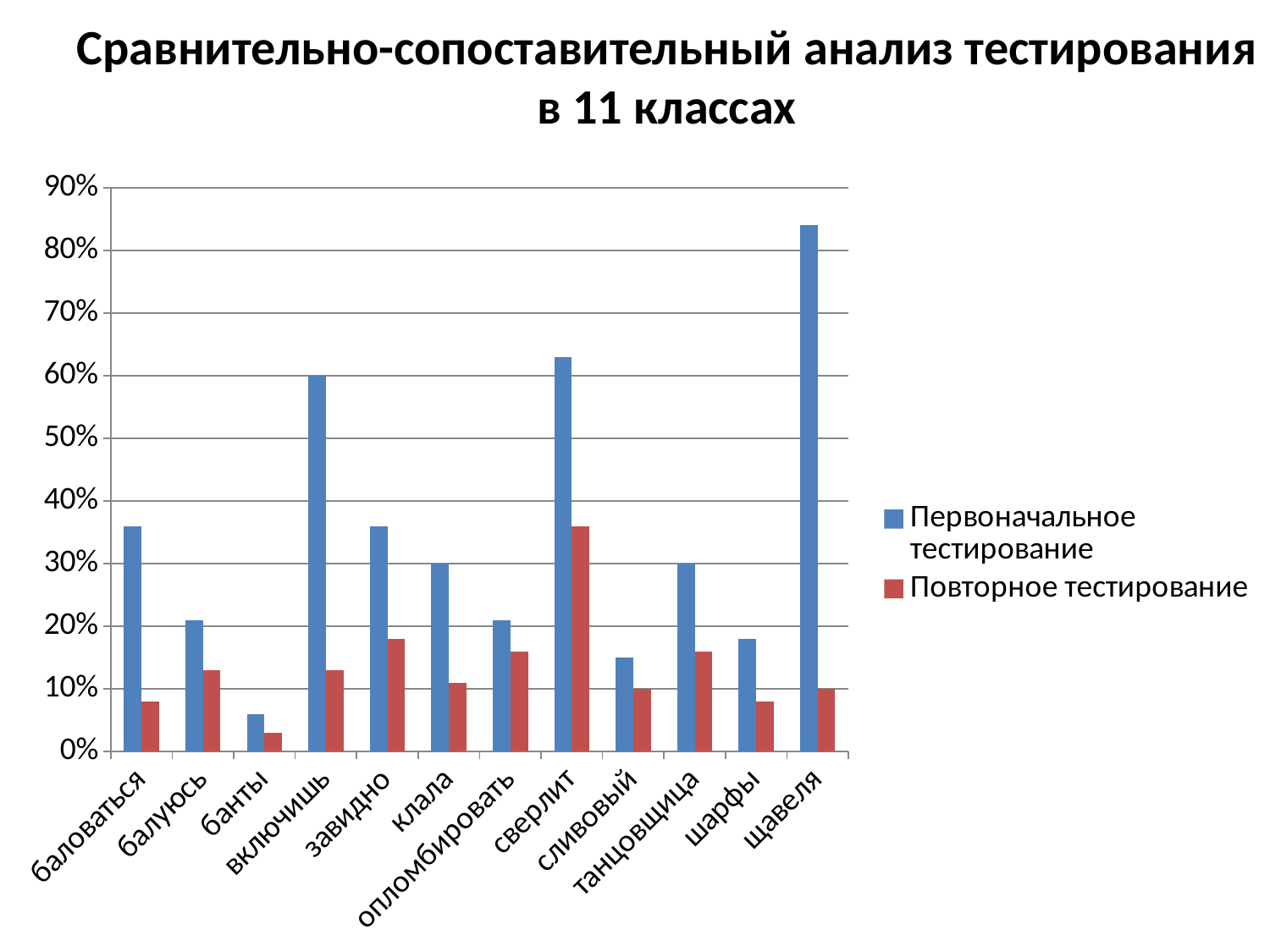
How many categories (words) are shown on the x axis? 12 What kind of chart is shown on the slide? bar chart Which category has the highest value for Первоначальное тестирование? щавеля Is the Первоначальное тестирование value for банты greater or less than 10%? less Is the Первоначальное тестирование value for щавеля greater or less than 80%? greater Which category has the lowest value for Первоначальное тестирование? банты Which category has the highest value for Повторное тестирование? сверлит Which category has the lowest value for Повторное тестирование? банты How many series does the legend list? 2 Which is larger: the Первоначальное тестирование value for сверлит or for щавеля? щавеля Which series is shown in red? Повторное тестирование Is the Повторное тестирование value for сверлит greater or less than 30%? greater